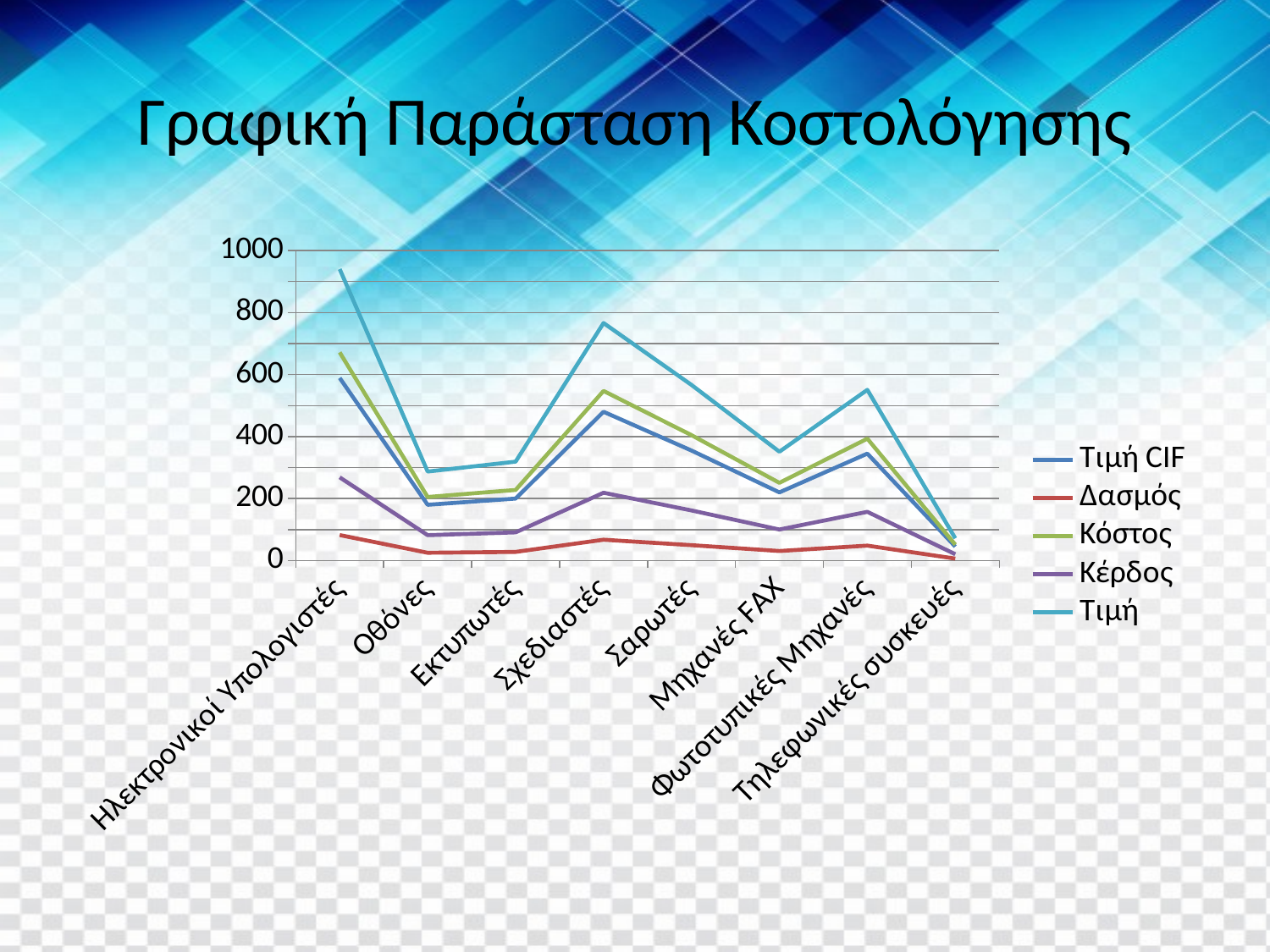
Does the Τιμή series rise or fall from Σχεδιαστές to Μηχανές FAX? Fall How many series does the legend list? 5 How many categories are shown on the x axis? 8 Is the Δασμός value for Οθόνες greater or less than 100? less What kind of chart is shown on the slide? Line chart Is the Τιμή value for Ηλεκτρονικοί Υπολογιστές greater or less than 800? greater Which category has the lowest value for the Τιμή series? Τηλεφωνικές συσκευές Is the Κόστος value for Ηλεκτρονικοί Υπολογιστές greater or less than 600? greater Which has the larger Τιμή value, Σχεδιαστές or Φωτοτυπικές Μηχανές? Σχεδιαστές Which series has the lowest values across all categories? Δασμός Which category has the highest value for the Τιμή series? Ηλεκτρονικοί Υπολογιστές What is the title of the slide containing the chart? Γραφική Παράσταση Κοστολόγησης